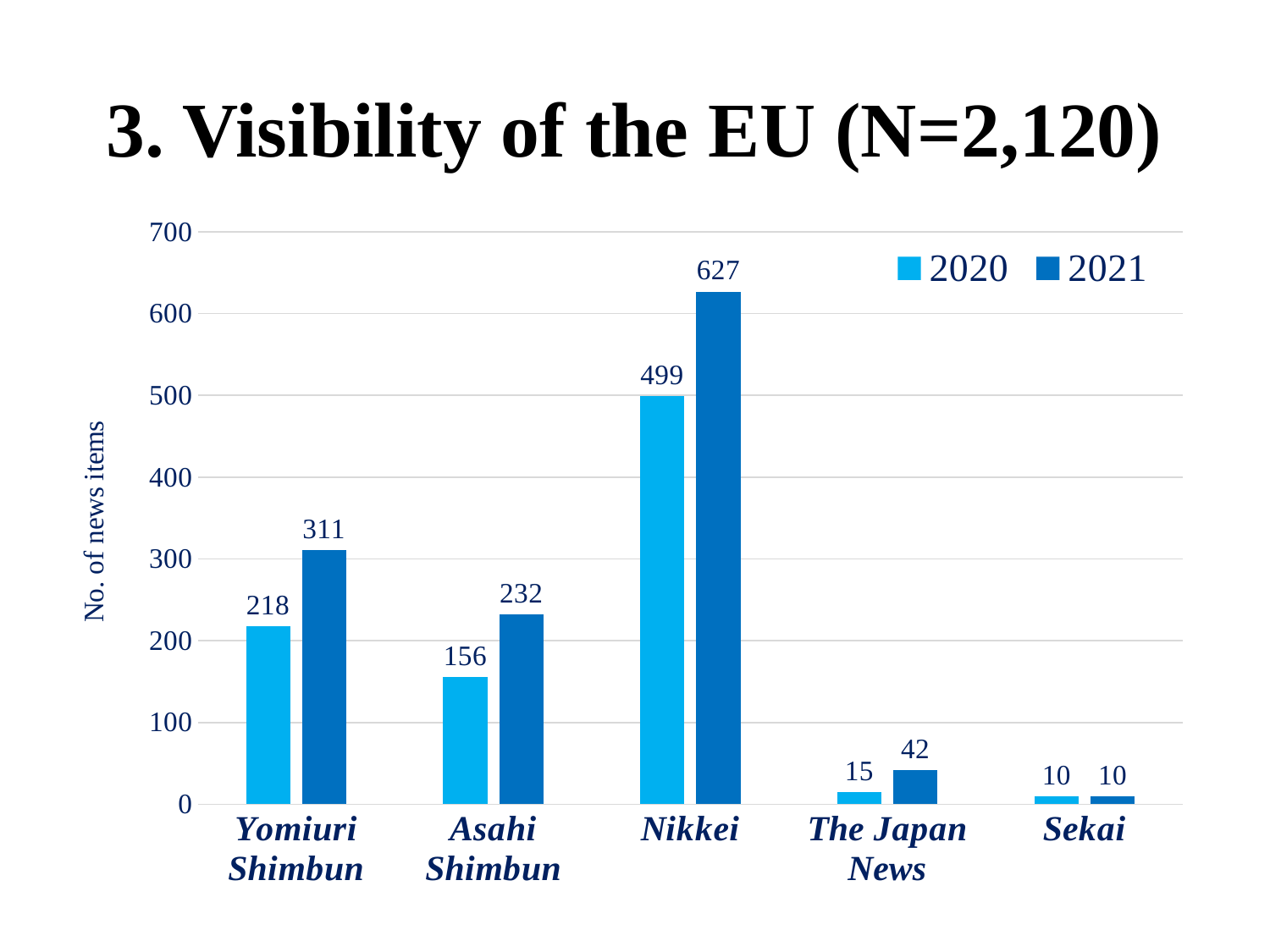
How many outlets are shown on the x axis? 5 Which outlet has the lowest number of news items in 2021? Sekai What is the label of the y axis? No. of news items What is the difference between the 2021 and 2020 values for Yomiuri Shimbun? 93 What is the value for The Japan News in 2021? 42 What is the difference between Nikkei's 2021 and 2020 values? 128 What is the number of news items for Nikkei in 2021? 627 What kind of chart is shown on the slide? Bar chart What is the number of news items for Asahi Shimbun in 2020? 156 Which is larger: Asahi Shimbun in 2021 or Yomiuri Shimbun in 2020? Asahi Shimbun in 2021 How many series does the legend list? 2 Which outlet has the highest number of news items in 2020? Nikkei